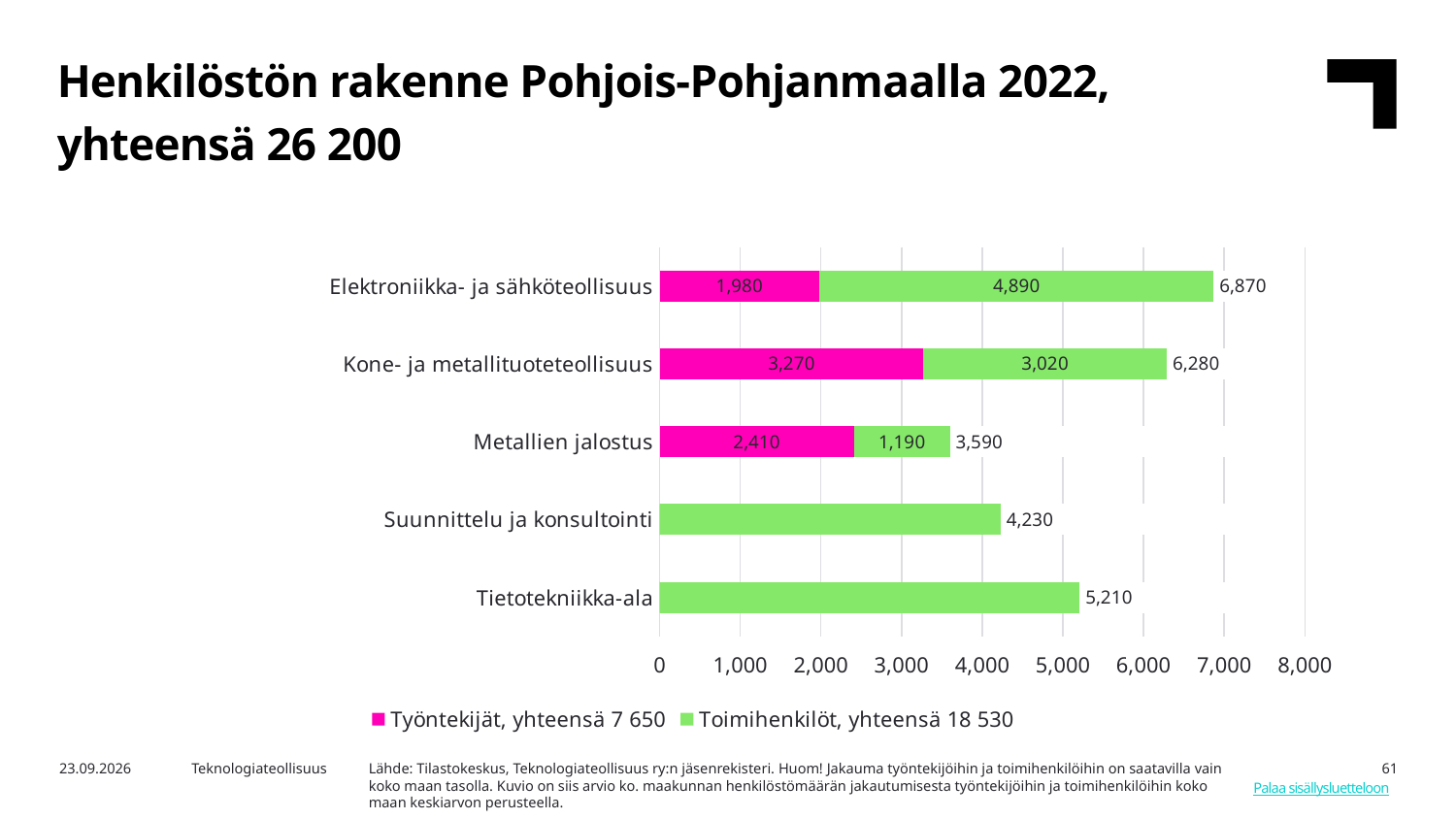
How many series does the legend list? 2 Which category has the lowest total? Metallien jalostus Is the total for Suunnittelu ja konsultointi greater or less than 4,000? greater Which is larger: the Työntekijät value for Metallien jalostus or the Työntekijät value for Elektroniikka- ja sähköteollisuus? Metallien jalostus What is the title of the slide? Henkilöstön rakenne Pohjois-Pohjanmaalla 2022, yhteensä 26 200 What is the total for the Metallien jalostus bar? 3,590 What is the difference between the totals of Tietotekniikka-ala and Suunnittelu ja konsultointi? 980 What is the Työntekijät value for Kone- ja metallituoteteollisuus? 3,270 How many categories are shown on the chart? 5 Which category has the highest total? Elektroniikka- ja sähköteollisuus What kind of chart is shown on the slide? Stacked bar chart What is the Toimihenkilöt value for Elektroniikka- ja sähköteollisuus? 4,890